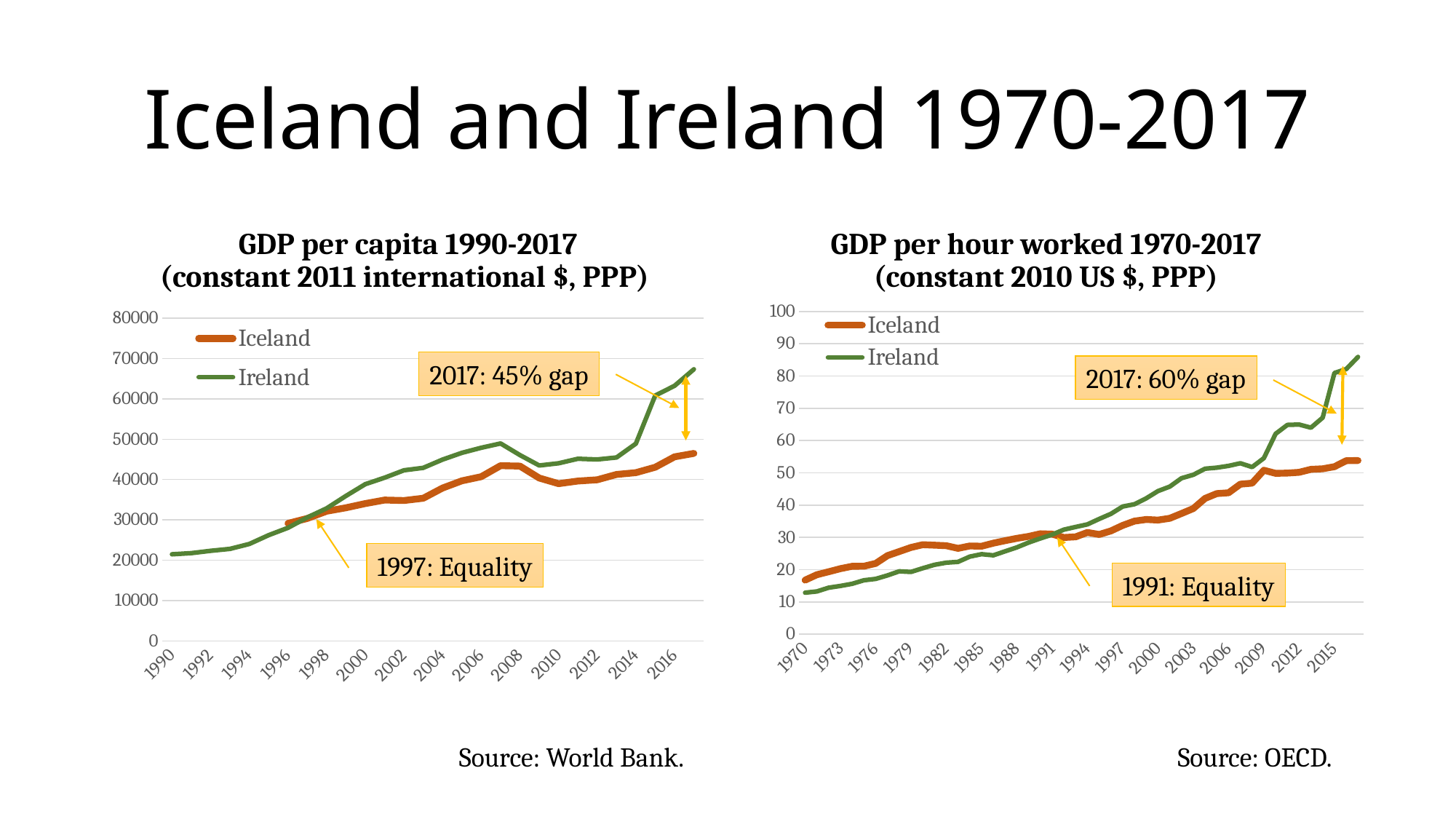
What kind of chart is the GDP per capita 1990-2017 chart on the left? line chart In the GDP per capita chart on the left, is the value for Iceland in 2017 greater or less than 50000? less According to the annotation on the GDP per capita chart on the left, what is the gap between Ireland and Iceland in 2017? 45% gap In the GDP per hour worked chart on the right, is the value for Ireland in 2017 greater or less than 80? greater In the GDP per capita chart on the left, is the value for Ireland in 2017 greater or less than 60000? greater According to the annotation on the GDP per capita chart on the left, in which year were Iceland and Ireland equal? 1997 In the GDP per hour worked chart on the right, does the Ireland series generally rise or fall from 1970 to 2017? rise According to the annotation on the GDP per hour worked chart on the right, what is the gap between Ireland and Iceland in 2017? 60% gap In the GDP per capita chart on the left, which series is higher in 2017, Iceland or Ireland? Ireland How many series does the legend of the GDP per hour worked chart on the right list? 2 What source is cited below the GDP per hour worked chart on the right? OECD